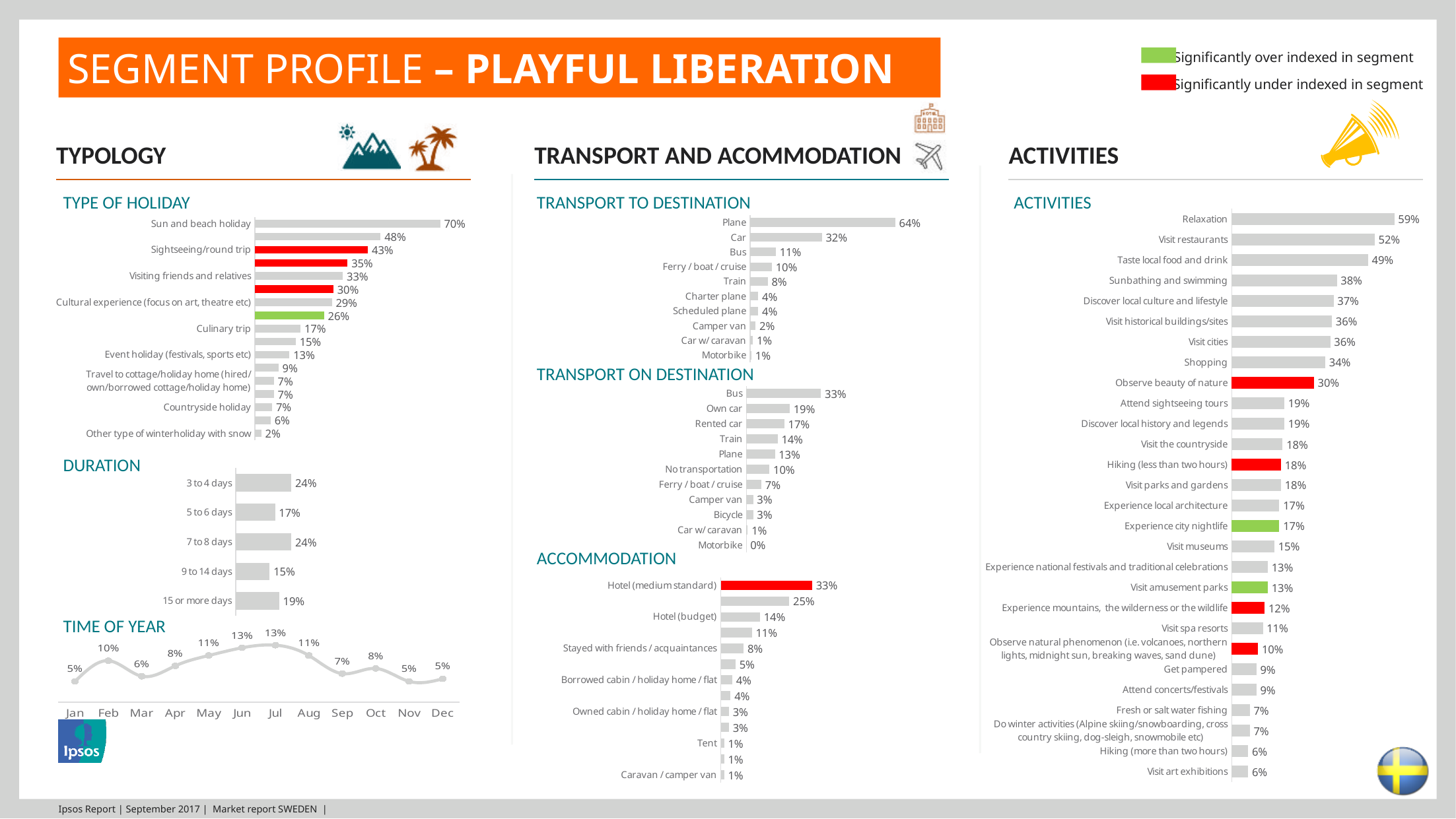
In the Accommodation chart, what percentage is shown for Hotel (medium standard)? 33% In the Transport on Destination chart, which category has the lowest value? Motorbike In the Duration chart, which is larger: 5 to 6 days or 15 or more days? 15 or more days What kind of chart is the Time of Year chart? line chart In the Activities chart, which activity has the highest value? Relaxation How many duration categories are shown in the Duration chart? 5 In the Time of Year chart, what percentage is shown for Jul? 13% In the Transport to Destination chart, what percentage is shown for Plane? 64% In the Transport to Destination chart, what is the difference between Plane and Car? 32% In the Time of Year chart, do the values rise or fall from Jul to Dec? fall In the Activities chart, what percentage is shown for Visit restaurants? 52% In the Type of Holiday chart, what percentage is shown for Sun and beach holiday? 70%